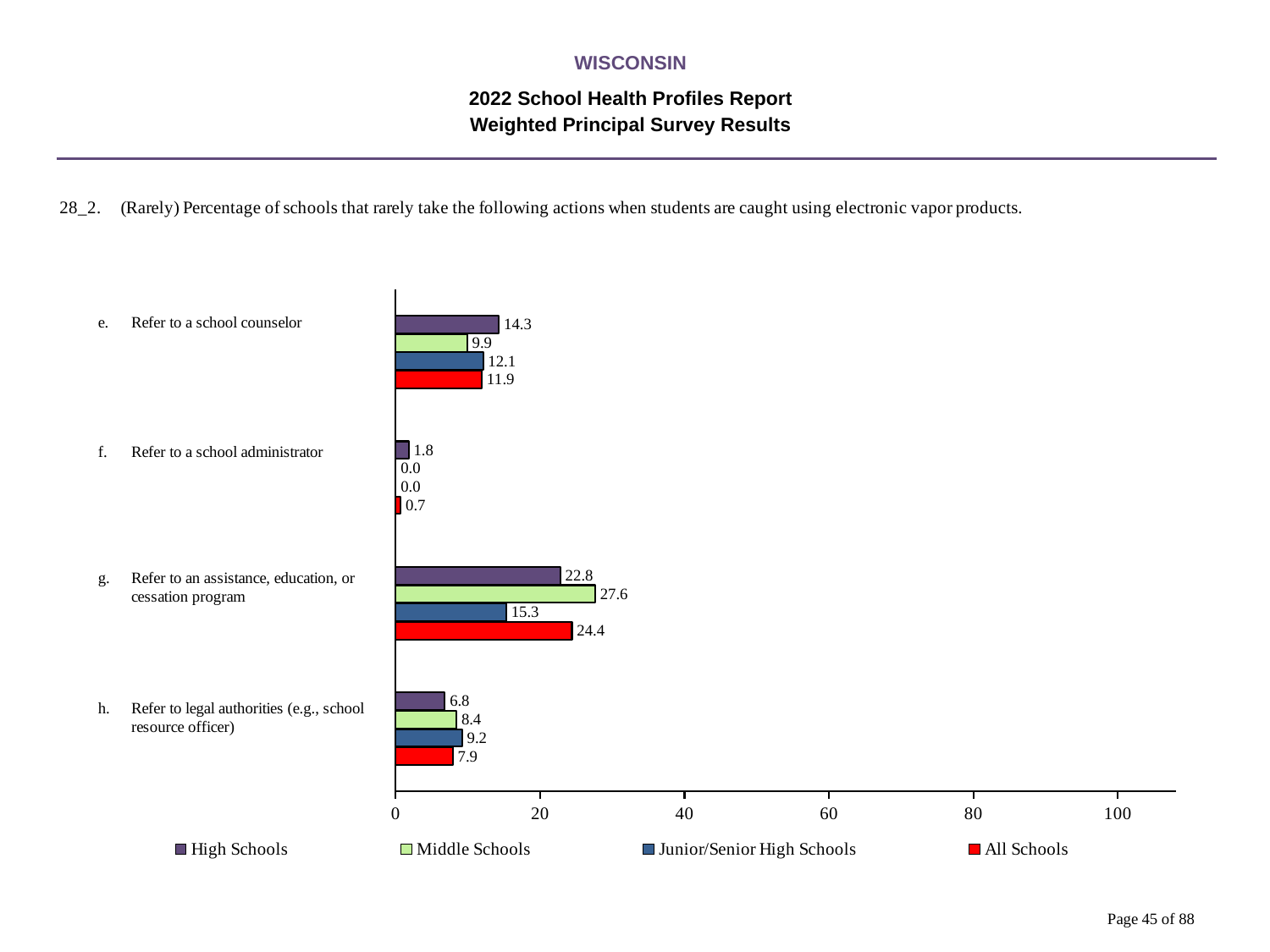
How many series does the legend list? 4 What is the value for All Schools for 'Refer to an assistance, education, or cessation program'? 24.4 Which category has the highest value for Middle Schools? Refer to an assistance, education, or cessation program What is the difference between the Middle Schools and High Schools values for 'Refer to an assistance, education, or cessation program'? 4.8 What is the value for Junior/Senior High Schools for 'Refer to legal authorities (e.g., school resource officer)'? 9.2 For 'Refer to a school counselor', which is larger: the High Schools value or the Middle Schools value? High Schools Which category has the lowest value for All Schools? Refer to a school administrator What kind of chart is shown on the slide? Bar chart Is the Middle Schools value for 'Refer to an assistance, education, or cessation program' greater or less than 20? greater What is the value for Middle Schools for 'Refer to a school administrator'? 0.0 What is the value for High Schools for 'Refer to a school counselor'? 14.3 How many categories (actions) are shown on the chart? 4